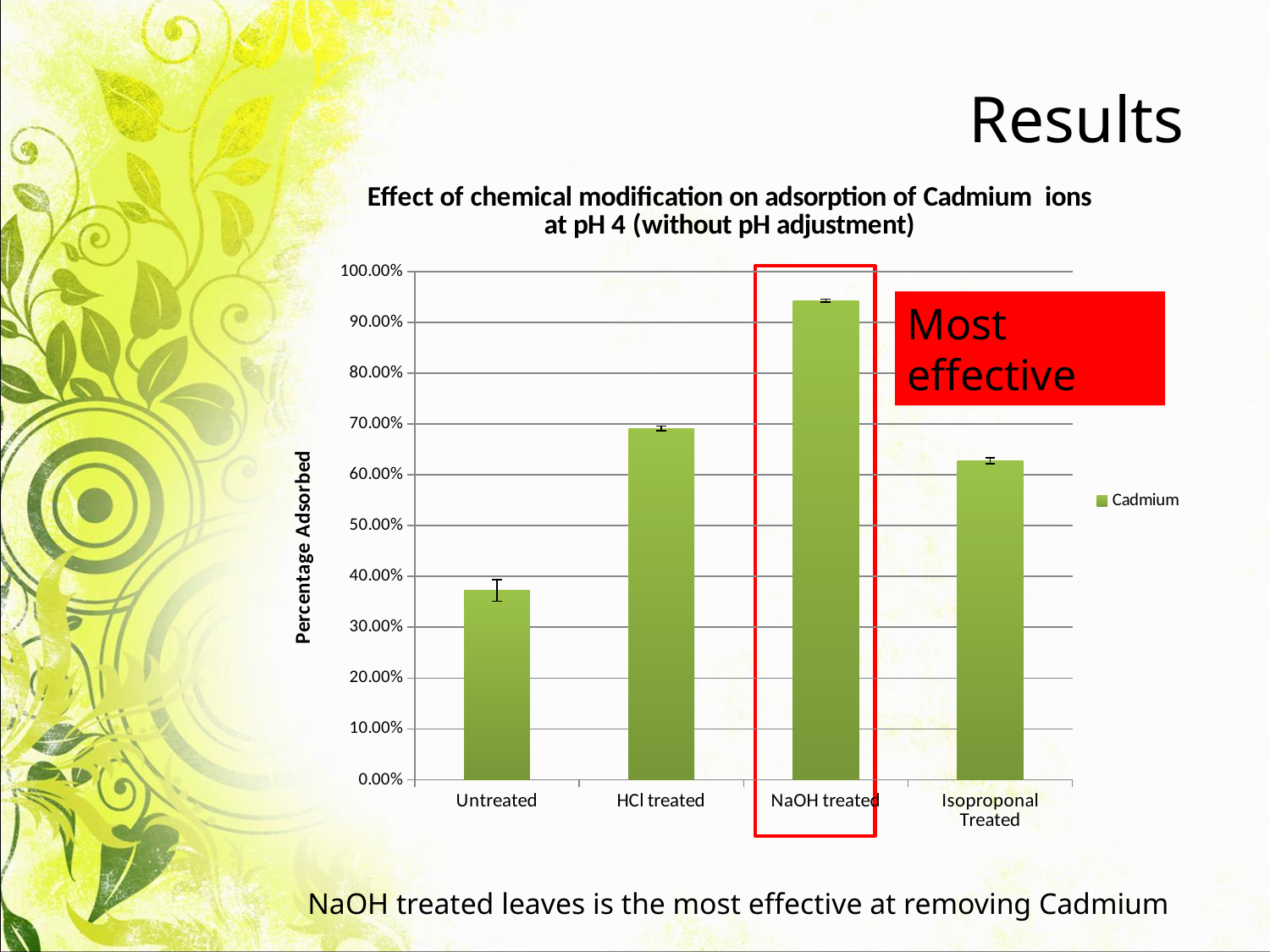
What is the title of the chart? Effect of chemical modification on adsorption of Cadmium ions at pH 4 (without pH adjustment) How many series does the legend list? 1 How many treatment categories are plotted on the x axis? 4 Is the value for NaOH treated greater or less than 90.00%? greater Which has a higher percentage adsorbed, HCl treated or Isoproponal Treated? HCl treated What is the label of the y axis? Percentage Adsorbed What type of chart is shown on the slide? bar chart Which treatment has the highest percentage adsorbed? NaOH treated Which treatment has the lowest percentage adsorbed? Untreated Is the value for Isoproponal Treated greater or less than 70.00%? less Is the value for HCl treated greater or less than 60.00%? greater